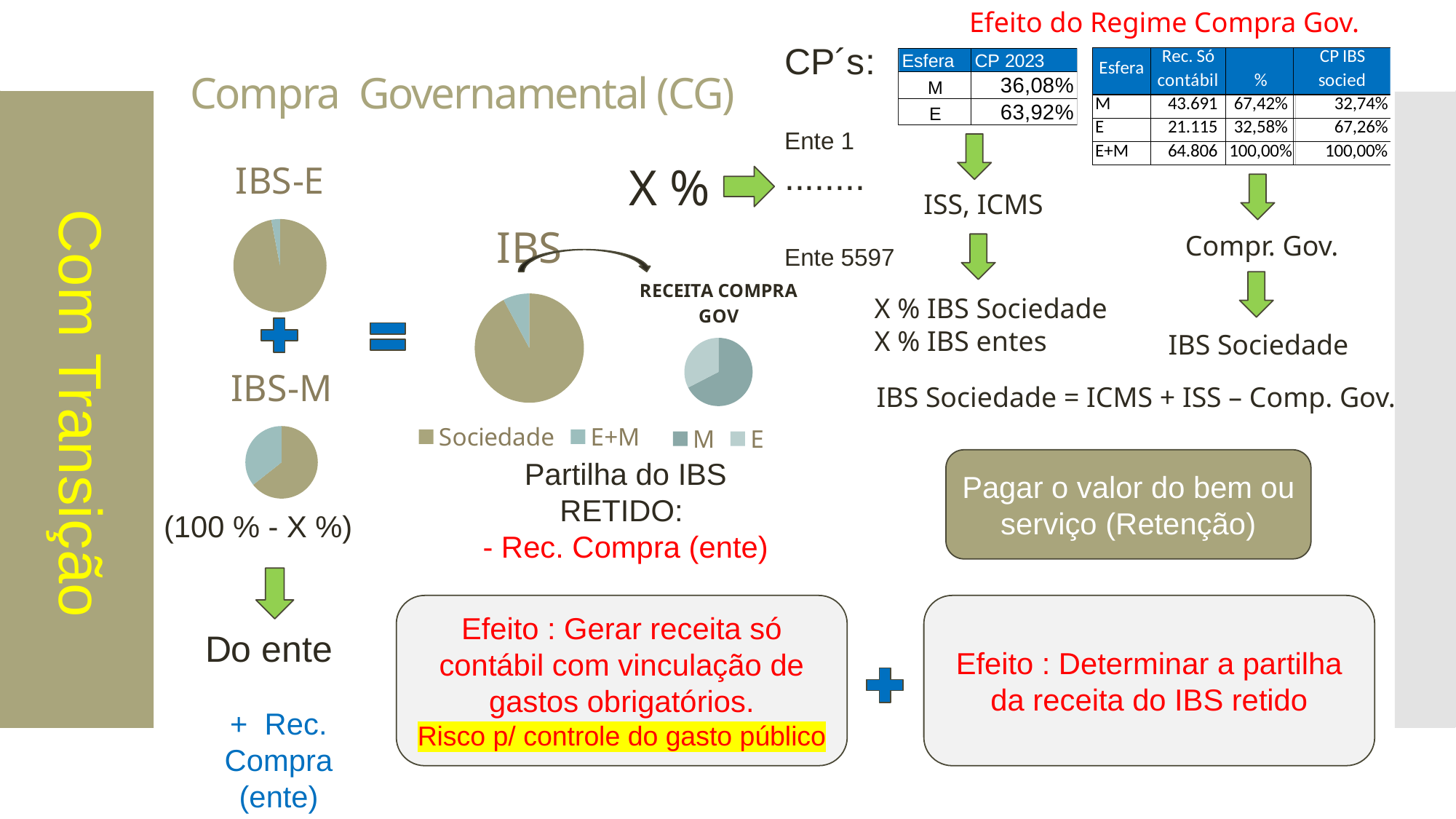
What are the legend entries of the "RECEITA COMPRA GOV" pie chart? M, E In the "RECEITA COMPRA GOV" pie chart, which slice is larger, M or E? M How many slices does the "IBS" pie chart have? 2 How many slices does the "RECEITA COMPRA GOV" pie chart have? 2 What kind of chart is the chart titled "RECEITA COMPRA GOV"? pie chart What are the legend entries of the "IBS" pie chart? Sociedade, E+M In the "IBS" pie chart, which slice is larger, Sociedade or E+M? Sociedade How many series does the legend of the "IBS" pie chart list? 2 In the "RECEITA COMPRA GOV" pie chart, which slice is the largest? M In the "IBS" pie chart, which slice is the smallest? E+M How many series does the legend of the "RECEITA COMPRA GOV" pie chart list? 2 What kind of chart is the chart labelled "IBS" in the middle of the slide? pie chart